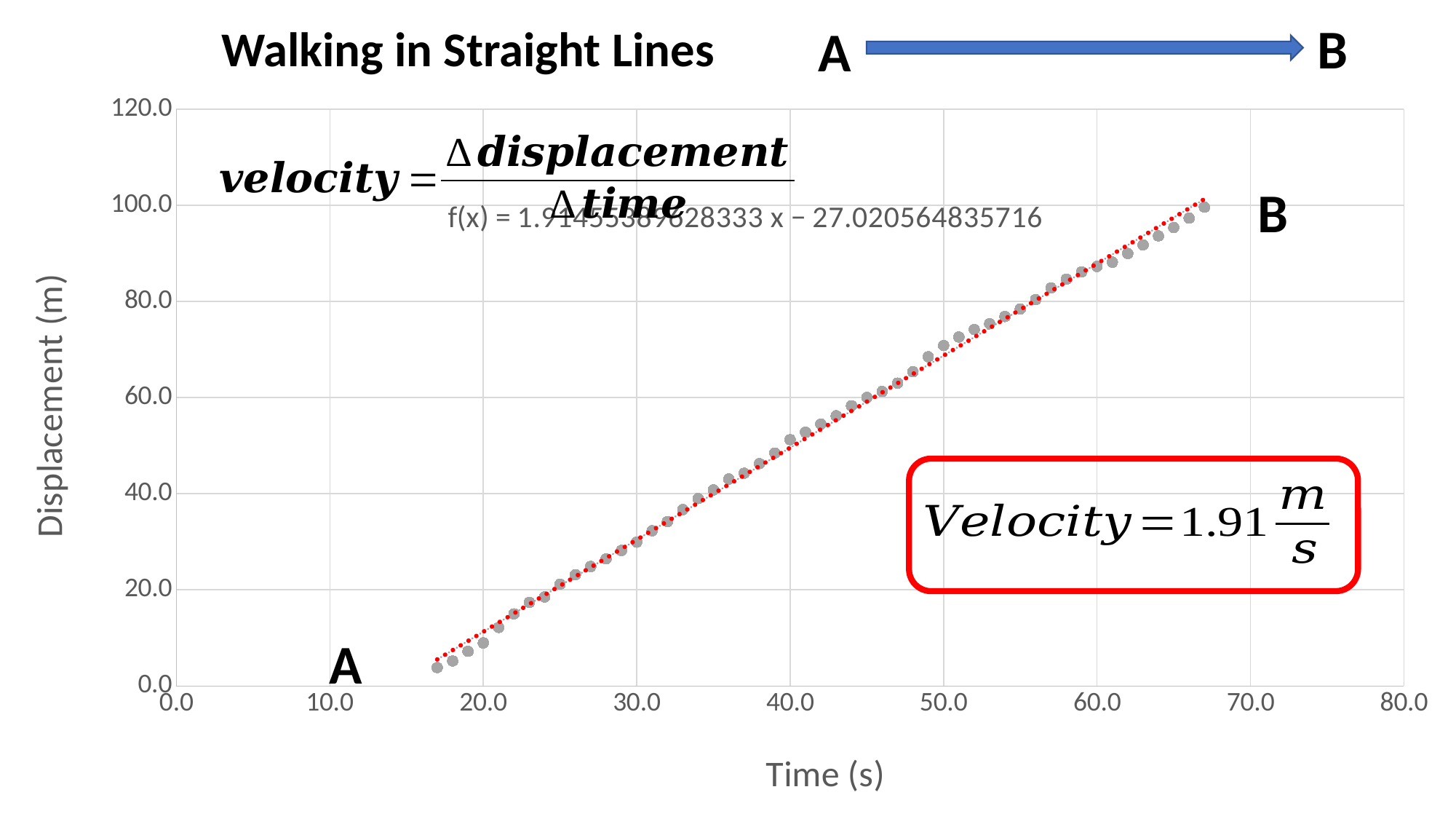
Is the displacement at a time of 30.0 s greater or less than 40.0 m? less Is the displacement at a time of 20.0 s greater or less than 20.0 m? less Do the displacement values rise or fall as time increases along the x axis? Rise What is the highest value shown on the x axis? 80.0 Is the displacement at a time of 60.0 s greater or less than 80.0 m? greater What kind of chart is shown on the slide? Scatter chart What is the highest value shown on the y axis? 120.0 Which point has the larger displacement, point A or point B? B What is the label of the y axis? Displacement (m) What is the title of the chart? Walking in Straight Lines What velocity value is shown in the red box on the chart? 1.91 m/s